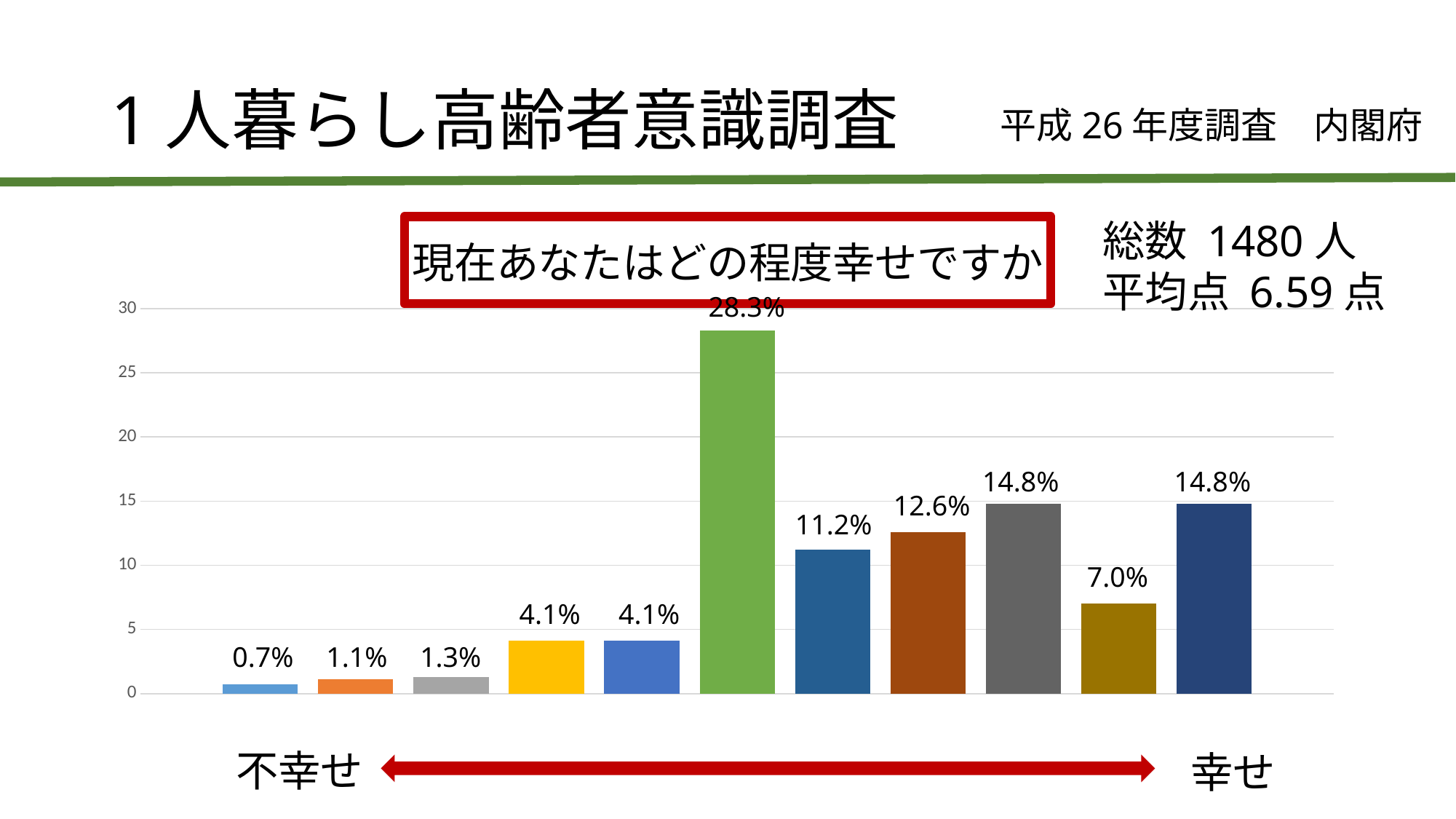
What is the value of the rightmost bar in the chart? 14.8% What is the value of the shortest bar in the chart? 0.7% What question is shown in the red box above the chart? 現在あなたはどの程度幸せですか Is the value of the tallest bar greater or less than 25? greater Do the values of the first five bars rise or fall from left to right? Rise What kind of chart is shown on the slide? Bar chart What is the difference between the tallest bar (28.3%) and the rightmost bar (14.8%)? 13.5 percentage points What is the value of the leftmost bar in the chart? 0.7% What is the value of the second bar from the right (the olive-coloured bar)? 7.0% How many bars are plotted in the chart? 11 What is the value of the tallest bar in the chart? 28.3% Which is larger, the seventh bar from the left (11.2%) or the eighth bar from the left (12.6%)? The eighth bar (12.6%)